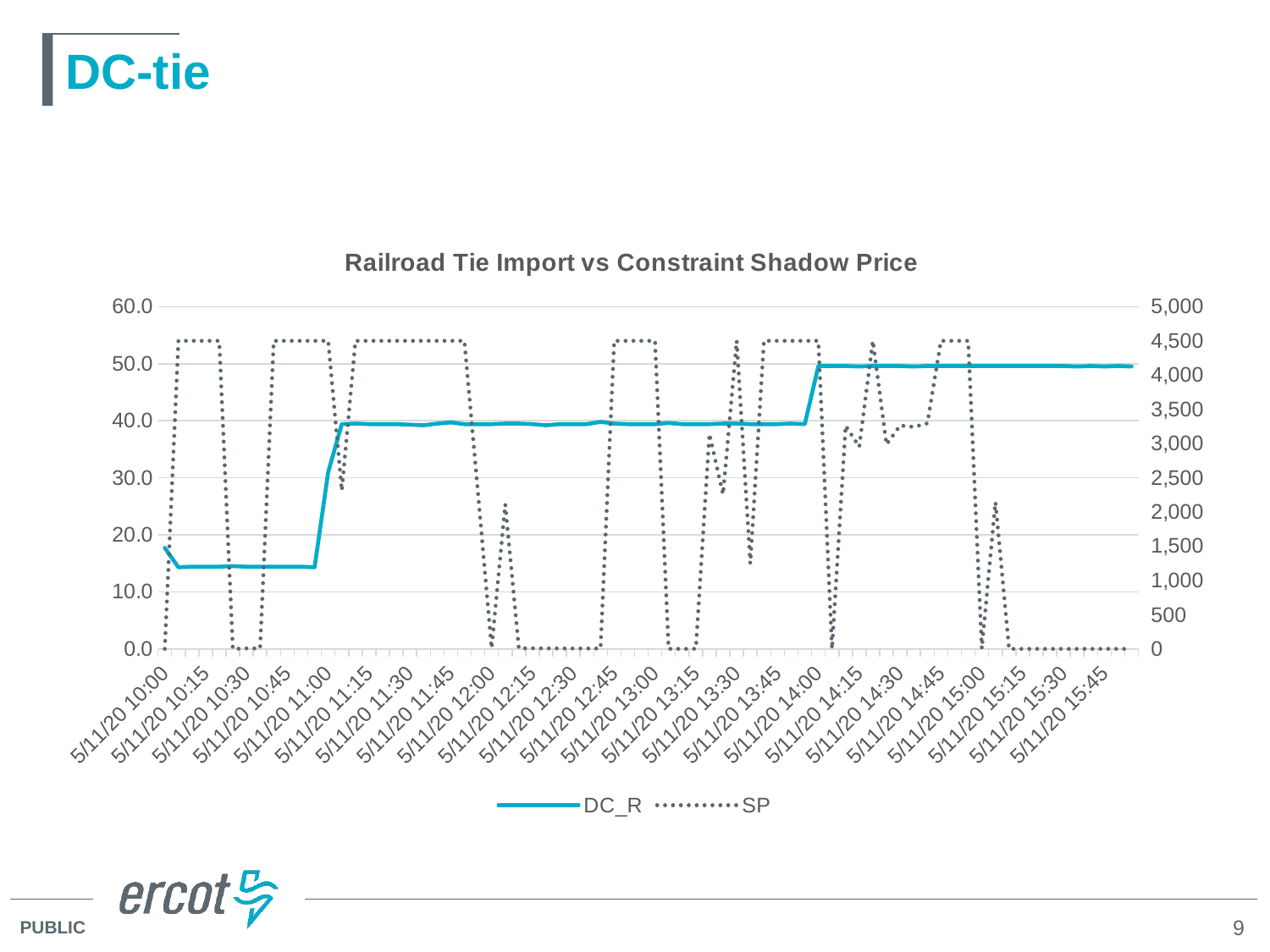
Which series is drawn with a dotted line? SP Is the DC_R value at 5/11/20 15:30 greater or less than 40.0? greater Is the DC_R value larger at 5/11/20 15:00 or at 5/11/20 10:30? 5/11/20 15:00 Is the SP value at 5/11/20 12:15 greater or less than 500? less What is the title of the chart? Railroad Tie Import vs Constraint Shadow Price How many time labels are shown on the x axis? 24 Is the DC_R value at 5/11/20 12:00 greater or less than 30.0? greater How many series does the legend list? 2 What kind of chart is shown on the slide? line chart Does the DC_R series generally rise or fall from 5/11/20 10:00 to 5/11/20 15:45? rise